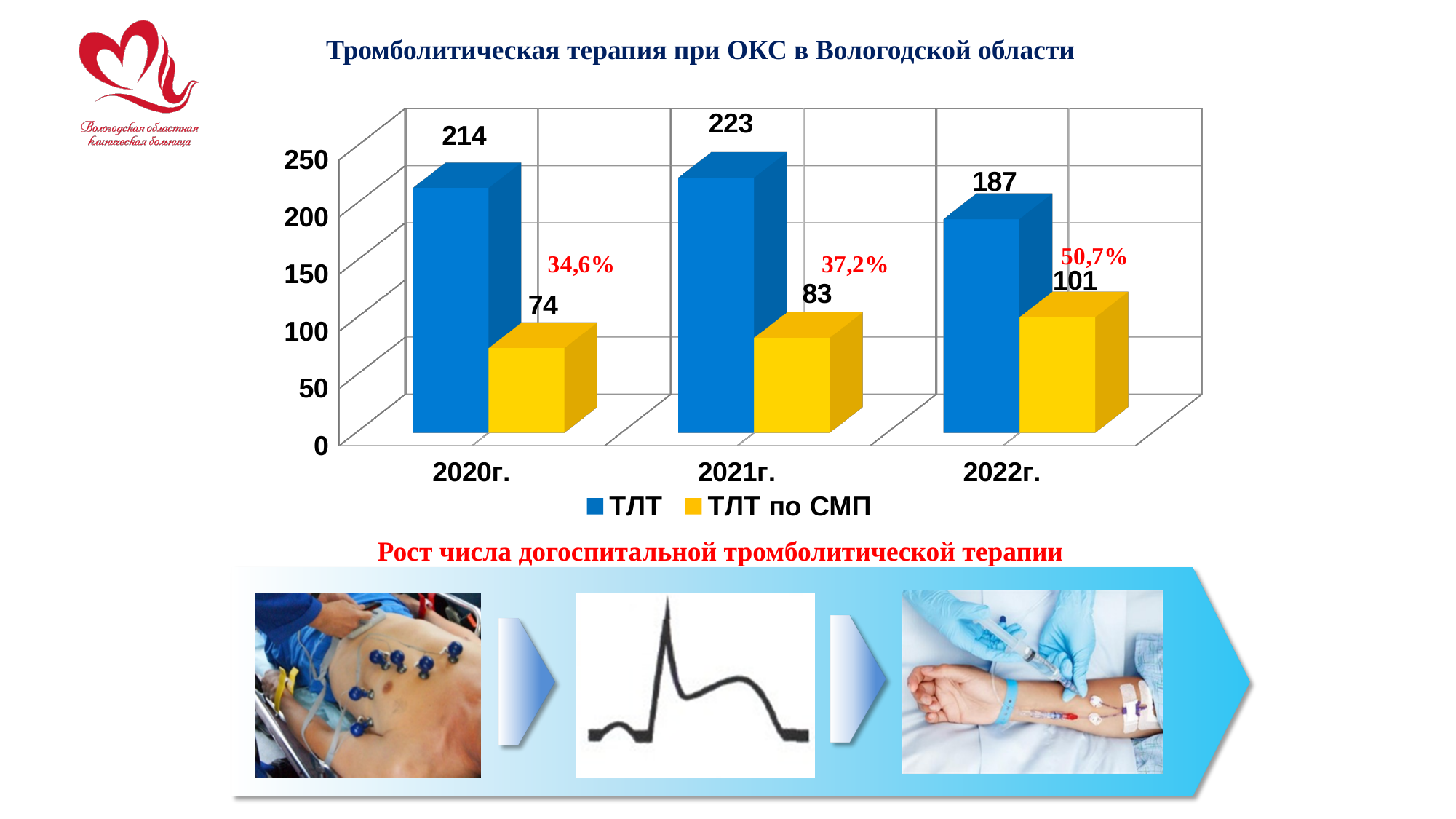
Which year has the highest ТЛТ value? 2021г. Do the ТЛТ по СМП values rise or fall from 2020г. to 2022г.? Rise What is the value of ТЛТ for 2021г.? 223 How many year categories are shown on the x axis? 3 What is the value of ТЛТ по СМП for 2020г.? 74 What is the difference between ТЛТ and ТЛТ по СМП in 2022г.? 86 What percentage is shown in red above the 2021г. group? 37,2% What kind of chart is shown on the slide? Bar chart How many series does the legend list? 2 What is the value of ТЛТ по СМП for 2022г.? 101 Which year has the lowest ТЛТ по СМП value? 2020г. Which is larger: ТЛТ in 2020г. or ТЛТ in 2022г.? ТЛТ in 2020г.